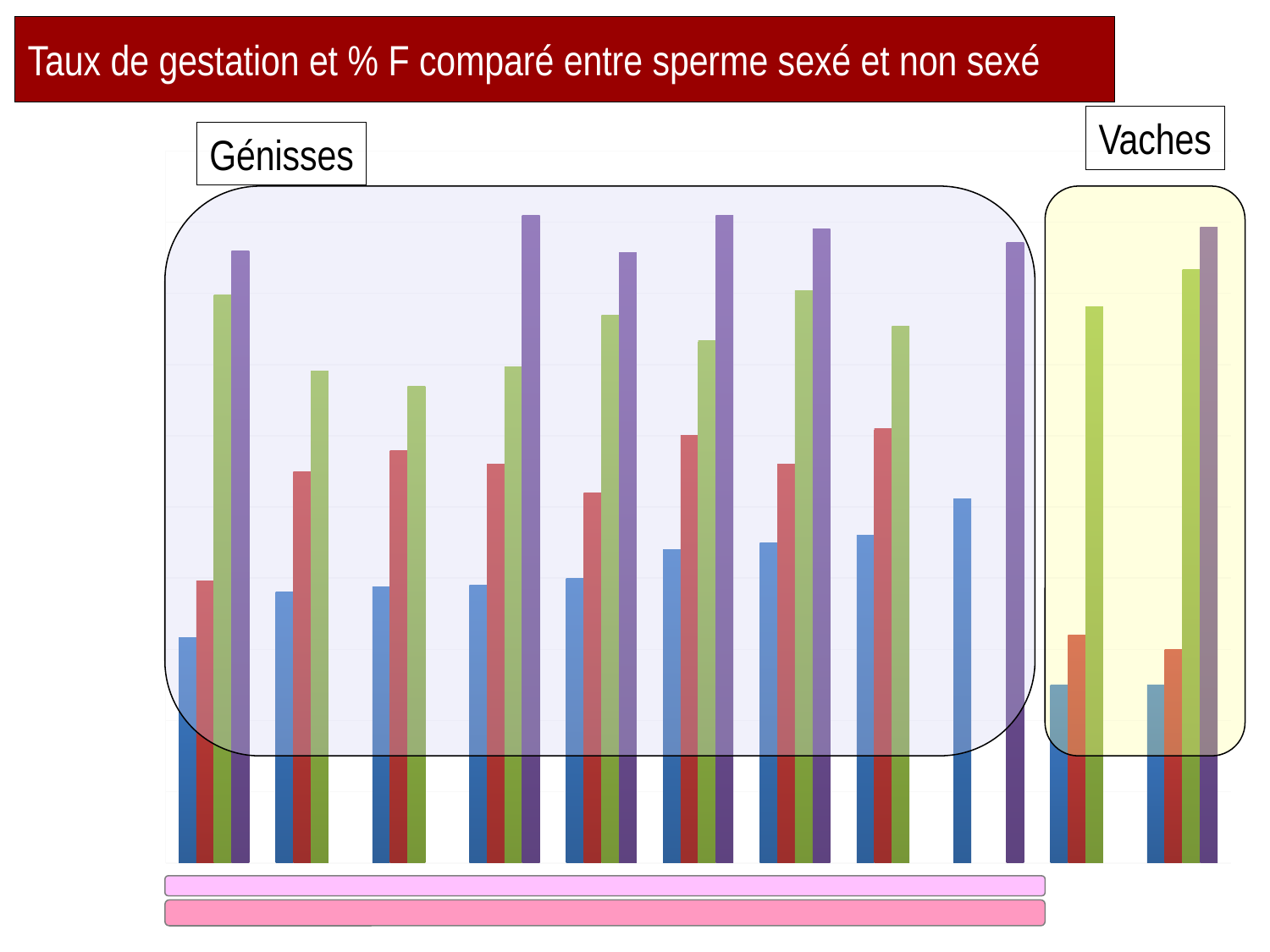
What is the title of the chart on the slide? Taux de gestation et % F comparé entre sperme sexé et non sexé In the leftmost group of bars, which colour bar is the shortest? blue Do the blue bars rise or fall from left to right across the Génisses region? rise Is the blue bar in the rightmost Génisses group taller or shorter than the blue bar in the first Vaches group? taller What kind of chart is shown on the slide? bar chart In the first group inside the Vaches region, is the green bar taller or shorter than the red bar? taller In the leftmost group of bars, which colour bar is the tallest? purple What are the labels of the two highlighted regions on the chart? Génisses and Vaches How many groups of bars fall inside the Vaches region? 2 How many groups of bars are plotted on the chart? 11